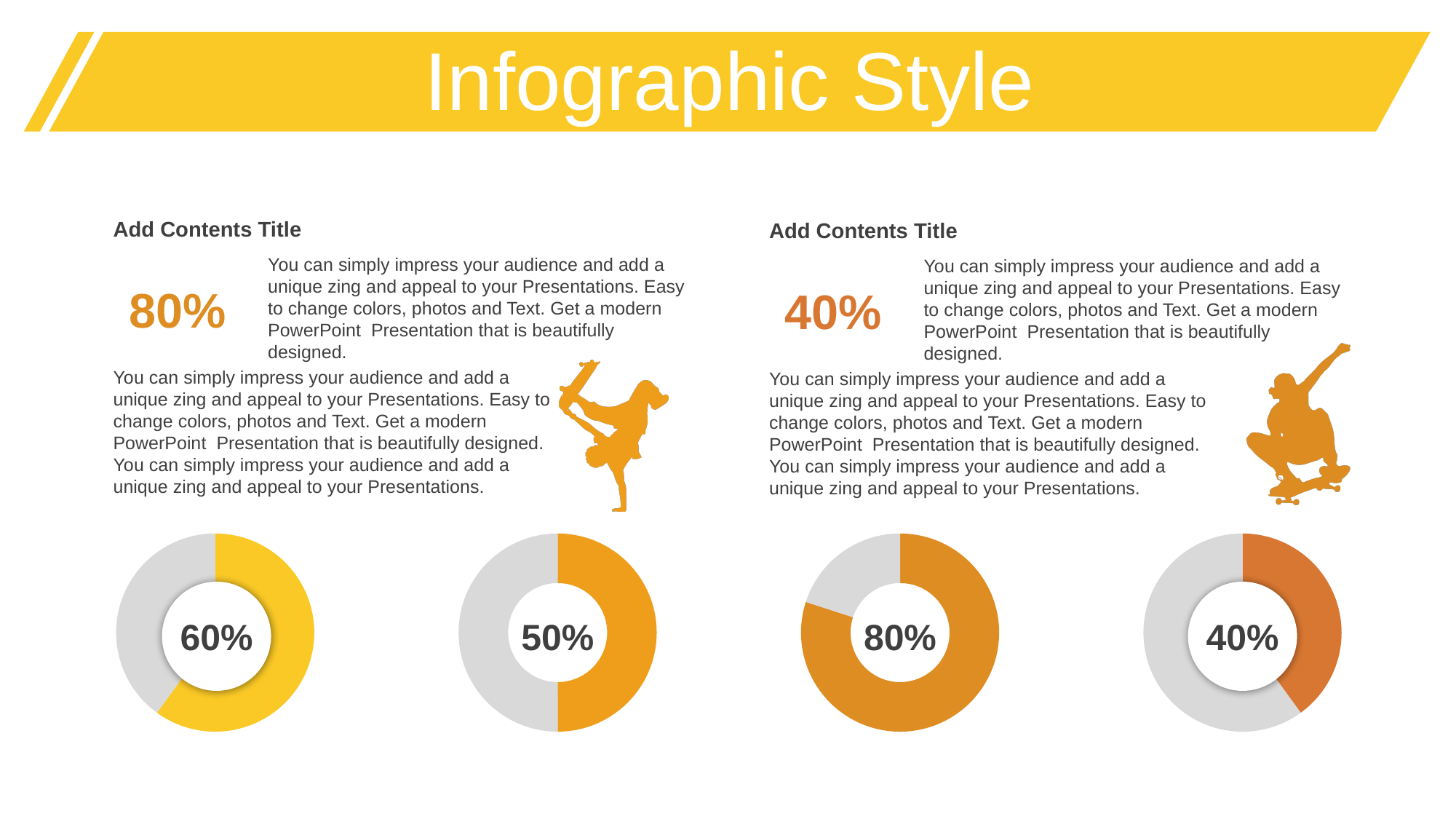
Which of the four donut charts shows the lowest percentage? The rightmost (40%) What colour is the filled segment of the leftmost donut chart? Yellow What percentage is shown in the centre of the third donut chart from the left? 80% What is the difference between the percentage in the third donut chart from the left and the percentage in the rightmost donut chart? 40% Which of the four donut charts shows the highest percentage? The third from the left (80%) How many donut charts are shown on the slide? 4 In the rightmost donut chart, what share of the ring is filled with the coloured segment? 40% What percentage is shown in the centre of the rightmost donut chart? 40% What kind of chart is used to display the percentages at the bottom of the slide? Donut chart What percentage is shown in the centre of the second donut chart from the left? 50% Which shows a larger percentage, the leftmost donut chart or the second donut chart from the left? The leftmost (60%) What percentage is shown in the centre of the leftmost donut chart? 60%